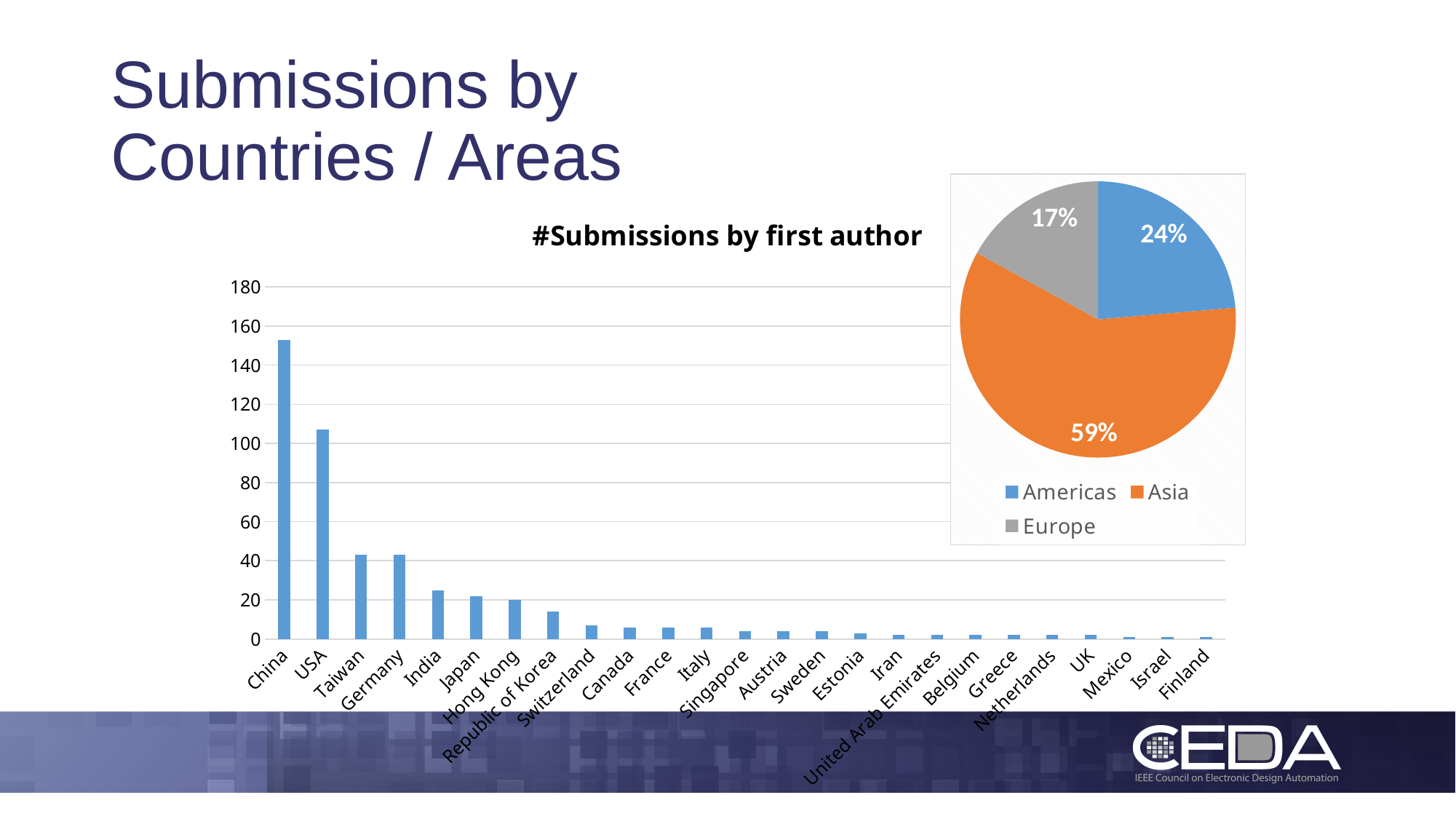
In the bar chart '#Submissions by first author', do the values rise or fall from left to right along the x axis? fall In the bar chart '#Submissions by first author', which country has the highest number of submissions? China In the bar chart '#Submissions by first author', which has more submissions, China or USA? China In the pie chart on the right, what is the difference between the Asia share and the Americas share? 35% In the bar chart '#Submissions by first author', is the value for USA greater or less than 100? greater In the bar chart '#Submissions by first author', is the value for Republic of Korea greater or less than 20? less In the pie chart on the right, what share of submissions comes from Asia? 59% What kind of chart is '#Submissions by first author'? bar chart In the pie chart on the right, which region has the smallest share? Europe In the bar chart '#Submissions by first author', is the value for China greater or less than 140? greater How many countries/areas are shown in the bar chart '#Submissions by first author'? 25